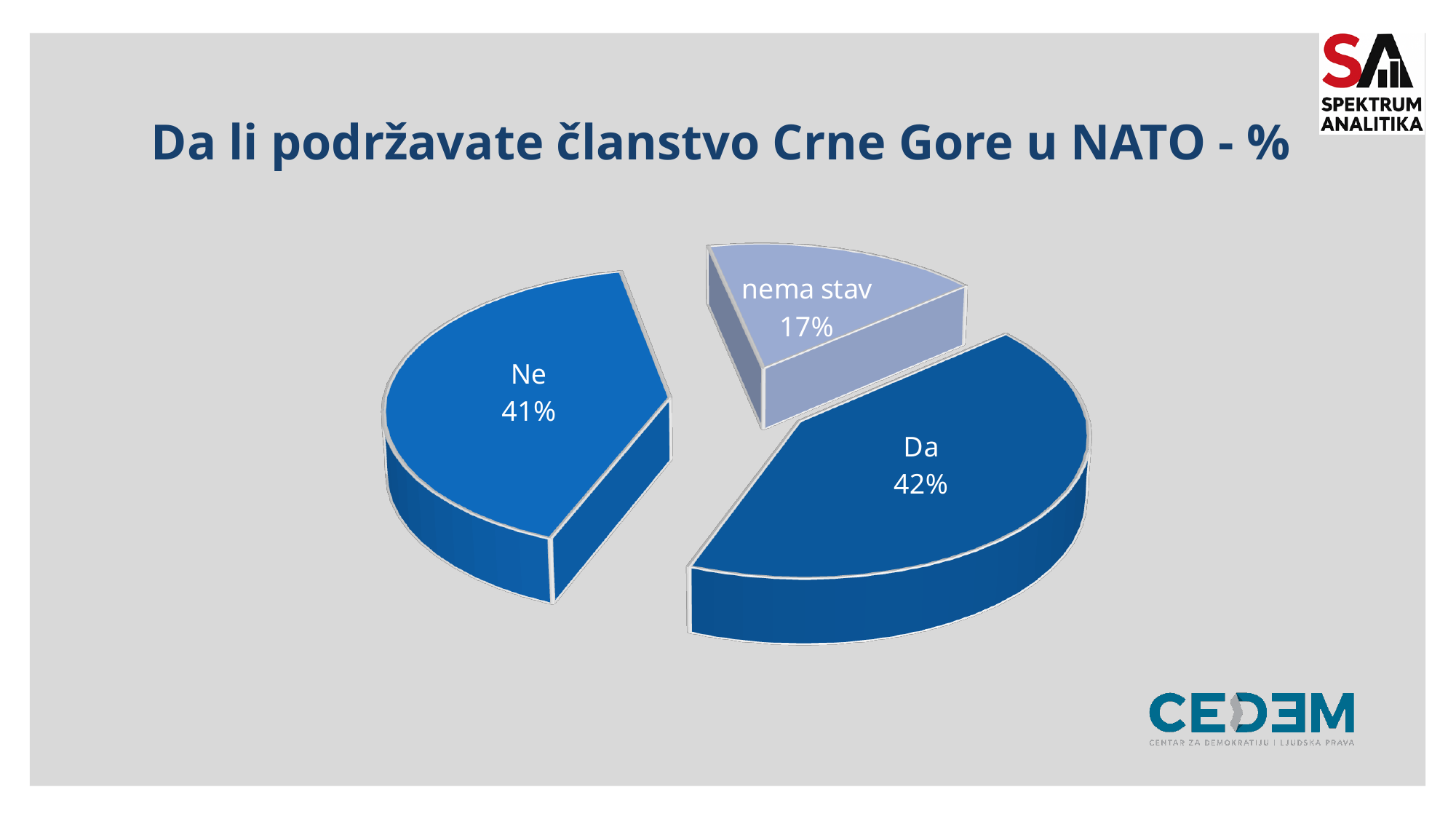
Which is larger, the "Da" slice or the "Ne" slice? Da Which is larger, the "Ne" slice or the "nema stav" slice? Ne What is the difference in percentage points between "Da" and "Ne"? 1 percentage point What type of chart is shown on the slide? Pie chart What percentage of respondents answered "Da"? 42% How many slices does the pie chart have? 3 What is the difference in percentage points between "Ne" and "nema stav"? 24 percentage points What is the title of the chart? Da li podržavate članstvo Crne Gore u NATO - % Which slice of the pie is the largest? Da What share of the pie is labelled "nema stav"? 17% Which slice of the pie is the smallest? nema stav What percentage of respondents answered "Ne"? 41%